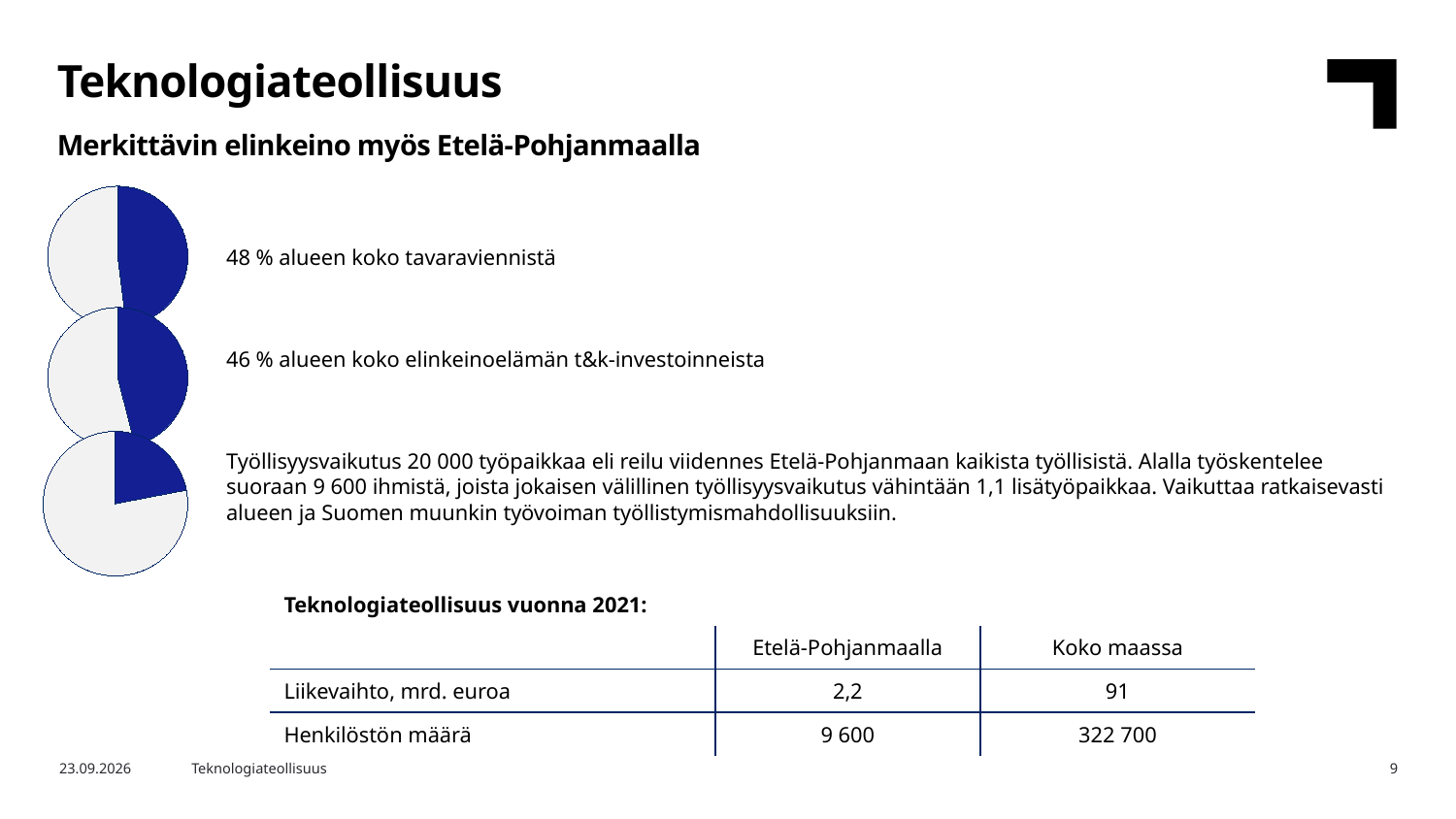
What kind of chart is shown at the top left of the slide? pie chart How many pie charts are on the slide? 3 Is the blue slice in the top pie chart greater or less than 25 %? greater How many slices does each pie chart have? 2 What colour is the highlighted slice in the pie charts? blue Which pie chart has the larger blue slice, the top one (tavaravienti) or the middle one (t&k-investoinnit)? the top one Is the blue slice in the bottom pie chart greater or less than 50 %? less What is the difference in percentage points between the blue slice of the top pie chart and the blue slice of the middle pie chart? 2 percentage points In the top pie chart, what share of the region's total goods exports does the blue slice represent? 48 % Which of the three pie charts has the smallest blue slice? the bottom one In the middle pie chart, what share of the region's business R&D investments does the blue slice represent? 46 %